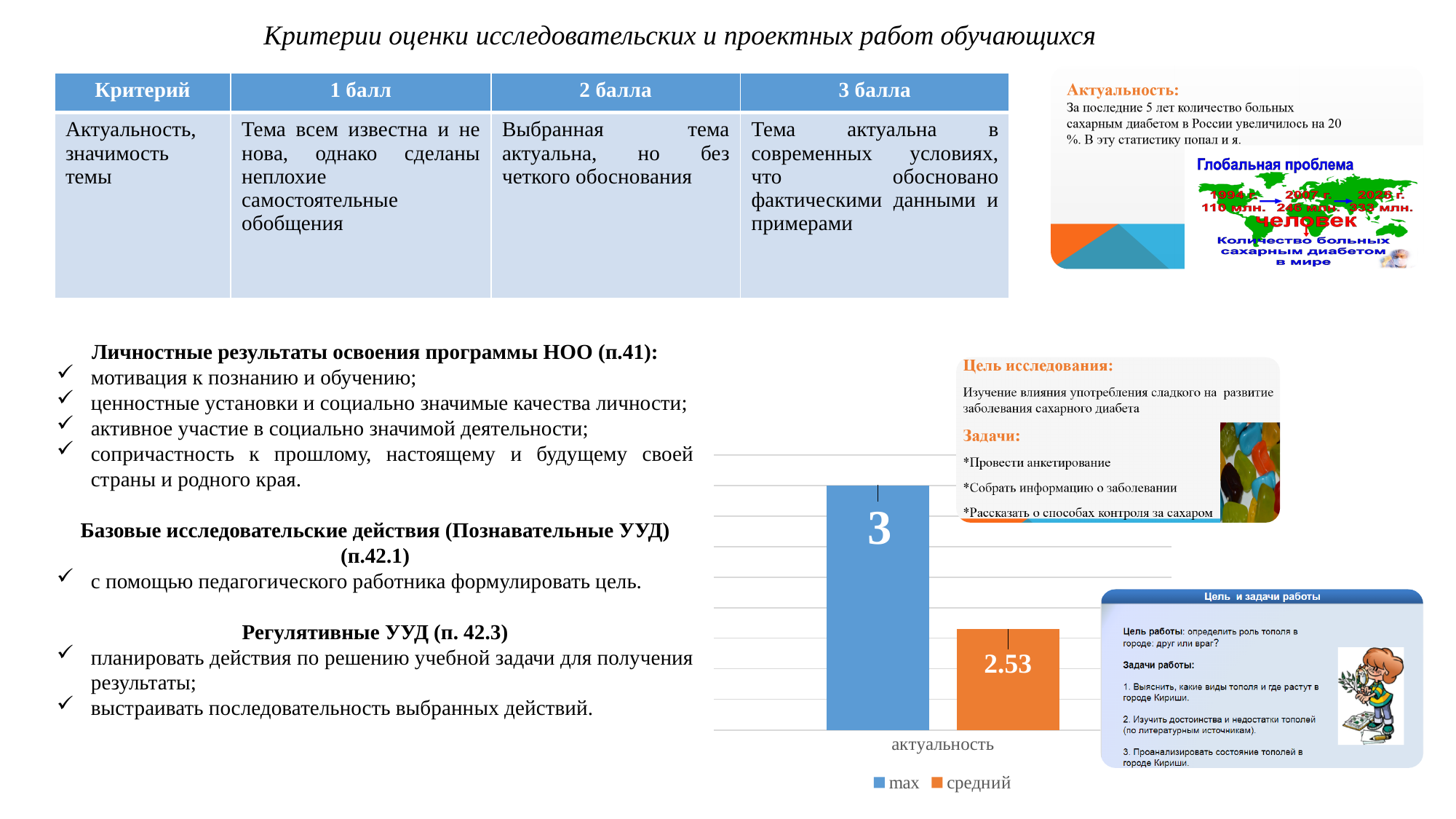
What is the value of the средний series for актуальность? 2.53 How many series does the chart legend list? 2 What is the difference between the max value and the средний value for актуальность? 0.47 What is the value of the max series for актуальность? 3 How many categories are shown on the x axis of the chart? 1 What is the category label shown on the x axis of the chart? актуальность Which series has the higher value for актуальность, max or средний? max Which series has the highest value in the chart? max Which series is shown in orange in the chart? средний What kind of chart is shown on the slide? bar chart Which series has the lowest value in the chart? средний